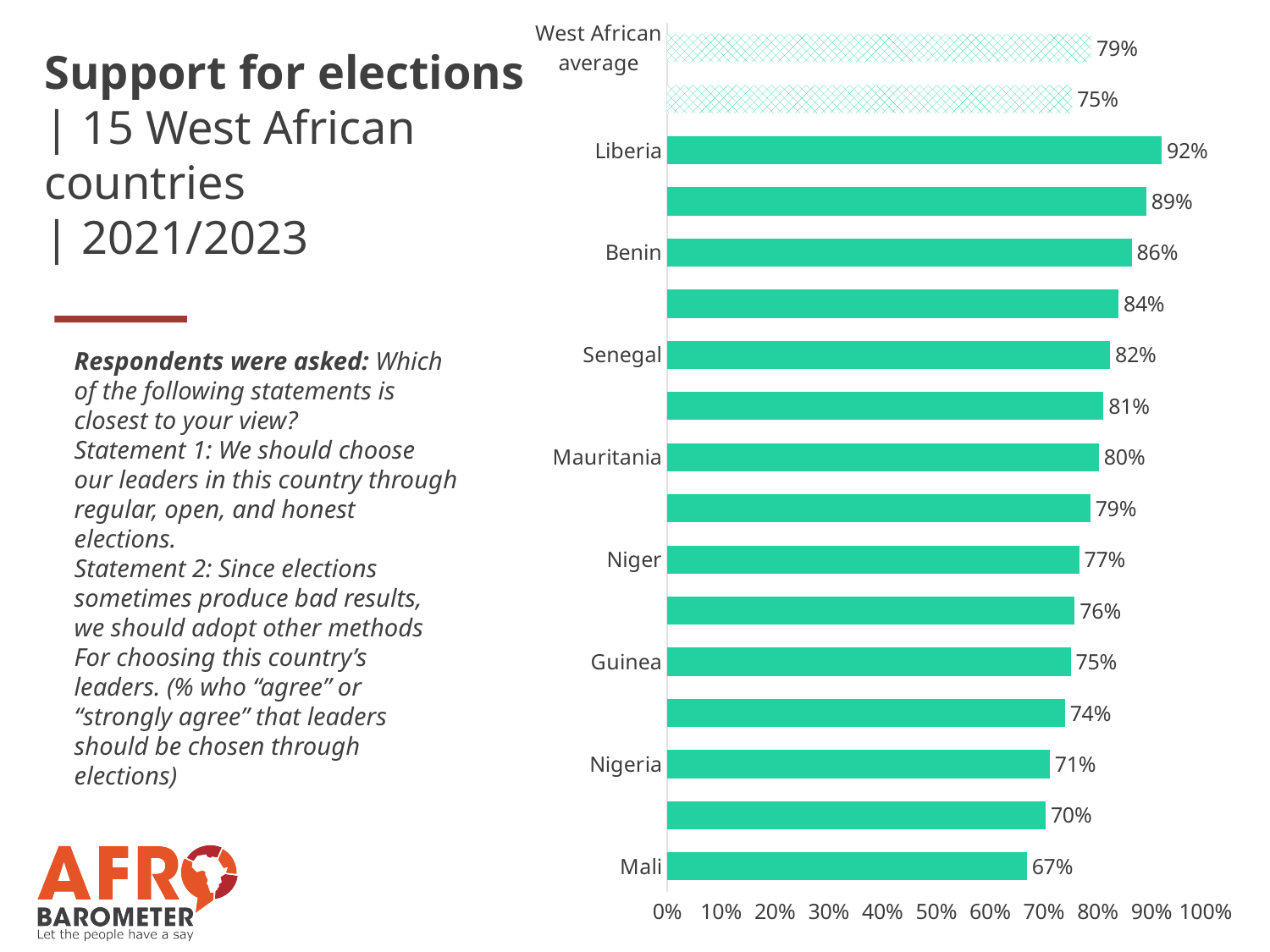
Which is larger, the value for Benin or the value for Senegal? Benin What is the difference between the values for Liberia and Mali? 25 percentage points What is the value for the West African average? 79% What is the value for Mali? 67% Do the country values increase or decrease going from the top of the chart to the bottom? Decrease What is the title of the slide? Support for elections | 15 West African countries | 2021/2023 What is the difference between the values for Niger and Guinea? 2 percentage points What is the value for Mauritania? 80% Which labelled country has the highest value? Liberia What is the value for Liberia? 92% What kind of chart is shown on the slide? Bar chart Which labelled country has the lowest value? Mali